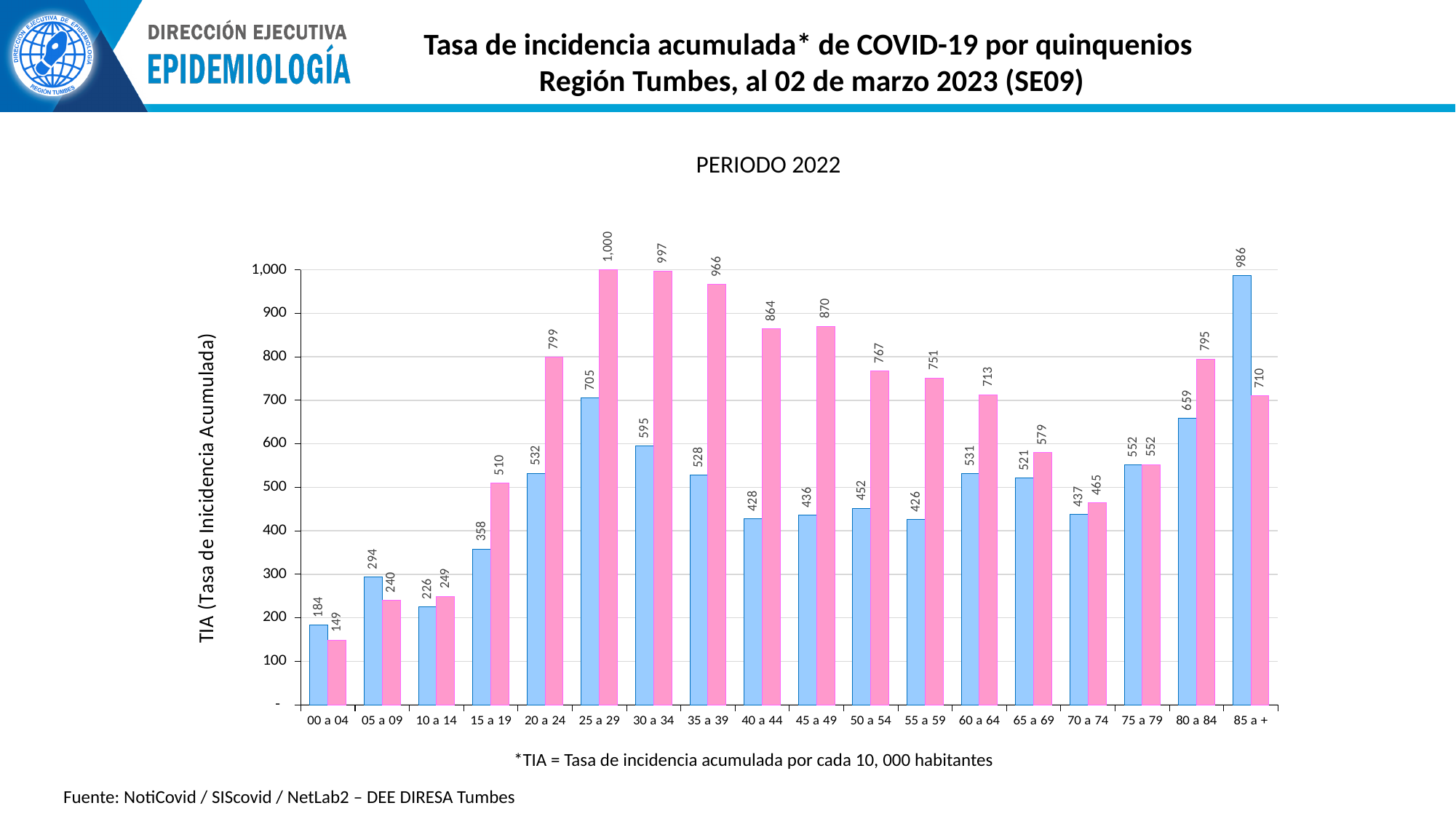
Which age group has the lowest pink bar? 00 a 04 What is the value of the blue bar for the 85 a + age group? 986 Which age group has the lowest blue bar? 00 a 04 What is the label of the y axis? TIA (Tasa de Incidencia Acumulada) What kind of chart is shown on the slide? bar chart Which age group has the highest pink bar? 25 a 29 For the 85 a + age group, which bar is larger, the blue or the pink? blue How many age groups are shown on the x axis? 18 What is the value of the blue bar for the 25 a 29 age group? 705 What is the value of the pink bar for the 40 a 44 age group? 864 Is the value of the pink bar for the 30 a 34 age group greater or less than 900? greater What is the difference between the pink bar and the blue bar for the 20 a 24 age group? 267